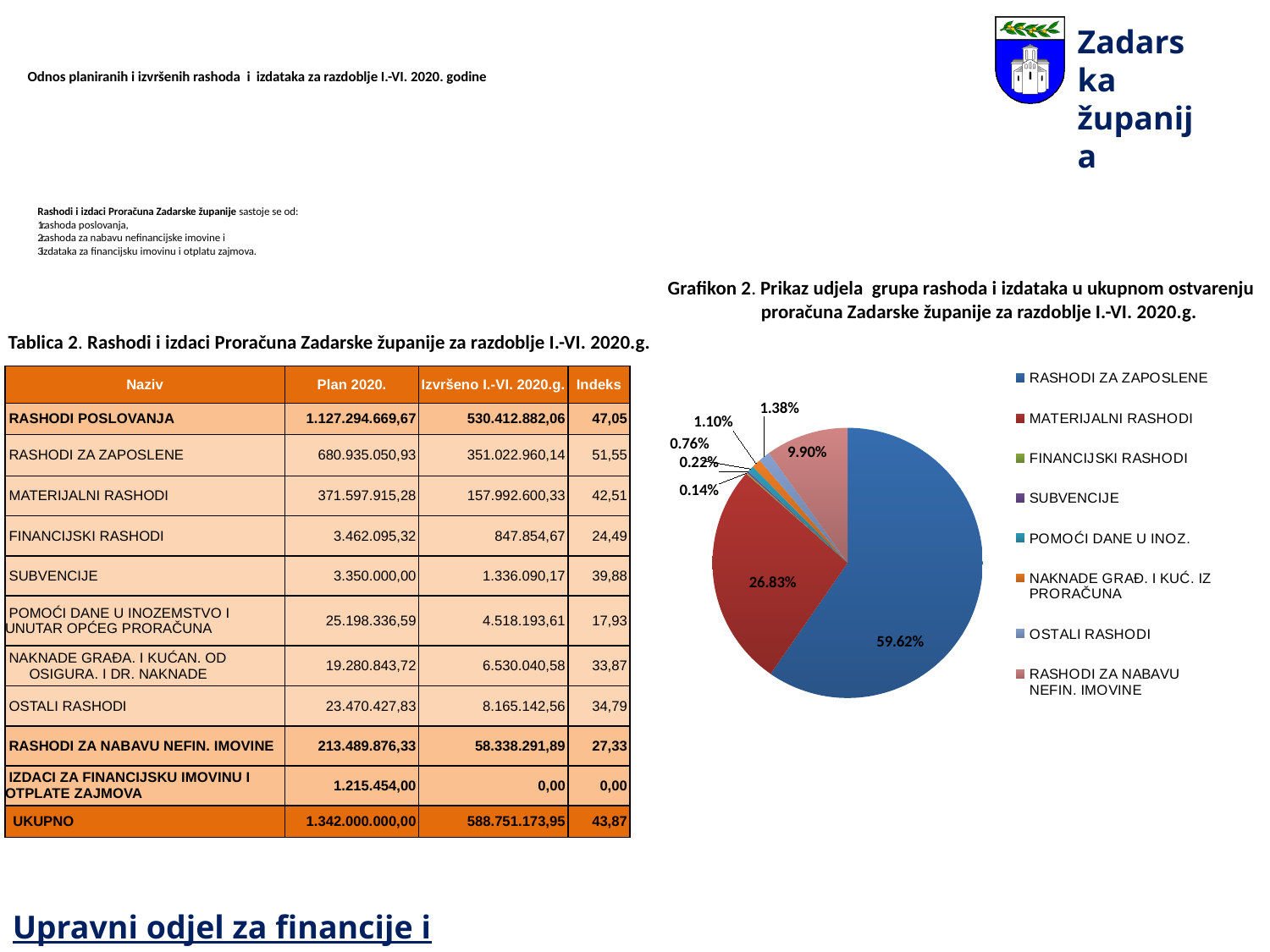
What share of the pie does RASHODI ZA NABAVU NEFIN. IMOVINE have? 9.90% What type of chart is shown on the slide? pie chart What colour is the slice for RASHODI ZA ZAPOSLENE? blue What share of the pie does RASHODI ZA ZAPOSLENE have? 59.62% Which category has the largest slice of the pie? RASHODI ZA ZAPOSLENE Which category has the smallest slice of the pie? FINANCIJSKI RASHODI Which slice is larger: MATERIJALNI RASHODI or RASHODI ZA NABAVU NEFIN. IMOVINE? MATERIJALNI RASHODI What is the difference in percentage points between the RASHODI ZA ZAPOSLENE slice and the MATERIJALNI RASHODI slice? 32.79 What share of the pie does MATERIJALNI RASHODI have? 26.83% How many categories does the legend of the pie chart list? 8 What is the title of the chart on the slide? Grafikon 2. Prikaz udjela grupa rashoda i izdataka u ukupnom ostvarenju proračuna Zadarske županije za razdoblje I.-VI. 2020.g. What is the smallest percentage label shown on the pie chart? 0.14%